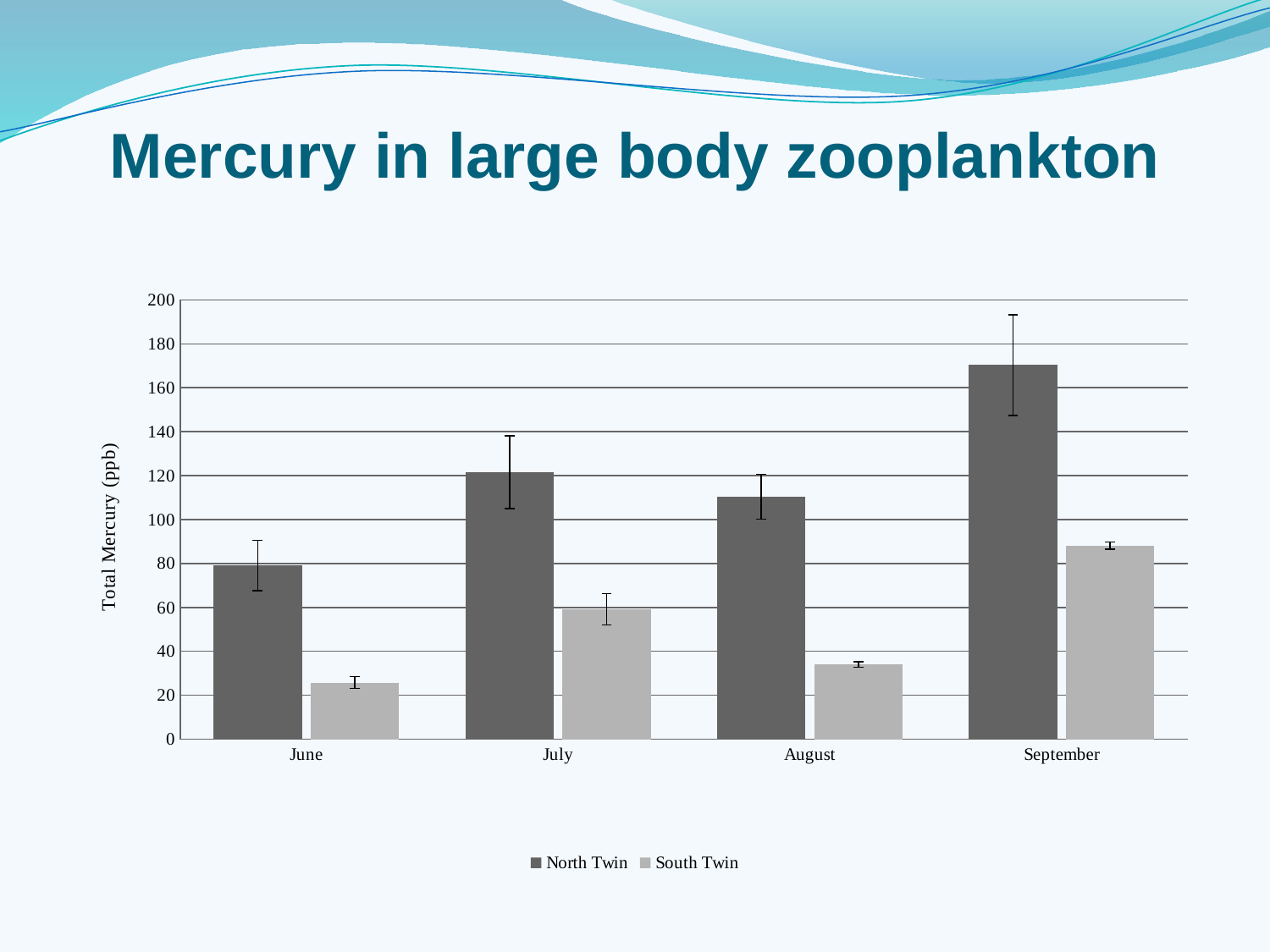
Which is larger for South Twin, the July value or the August value? July What kind of chart is shown on the slide? bar chart What is the label on the y axis? Total Mercury (ppb) How many months are shown on the x axis? 4 Is the South Twin value for June greater or less than 40? less Is the North Twin value for July greater or less than 100? greater In which month is the South Twin value lowest? June Which is larger in August, the North Twin value or the South Twin value? North Twin In which month is the South Twin value highest? September How many series does the legend list? 2 Is the North Twin value for September greater or less than 160? greater In which month is the North Twin value highest? September